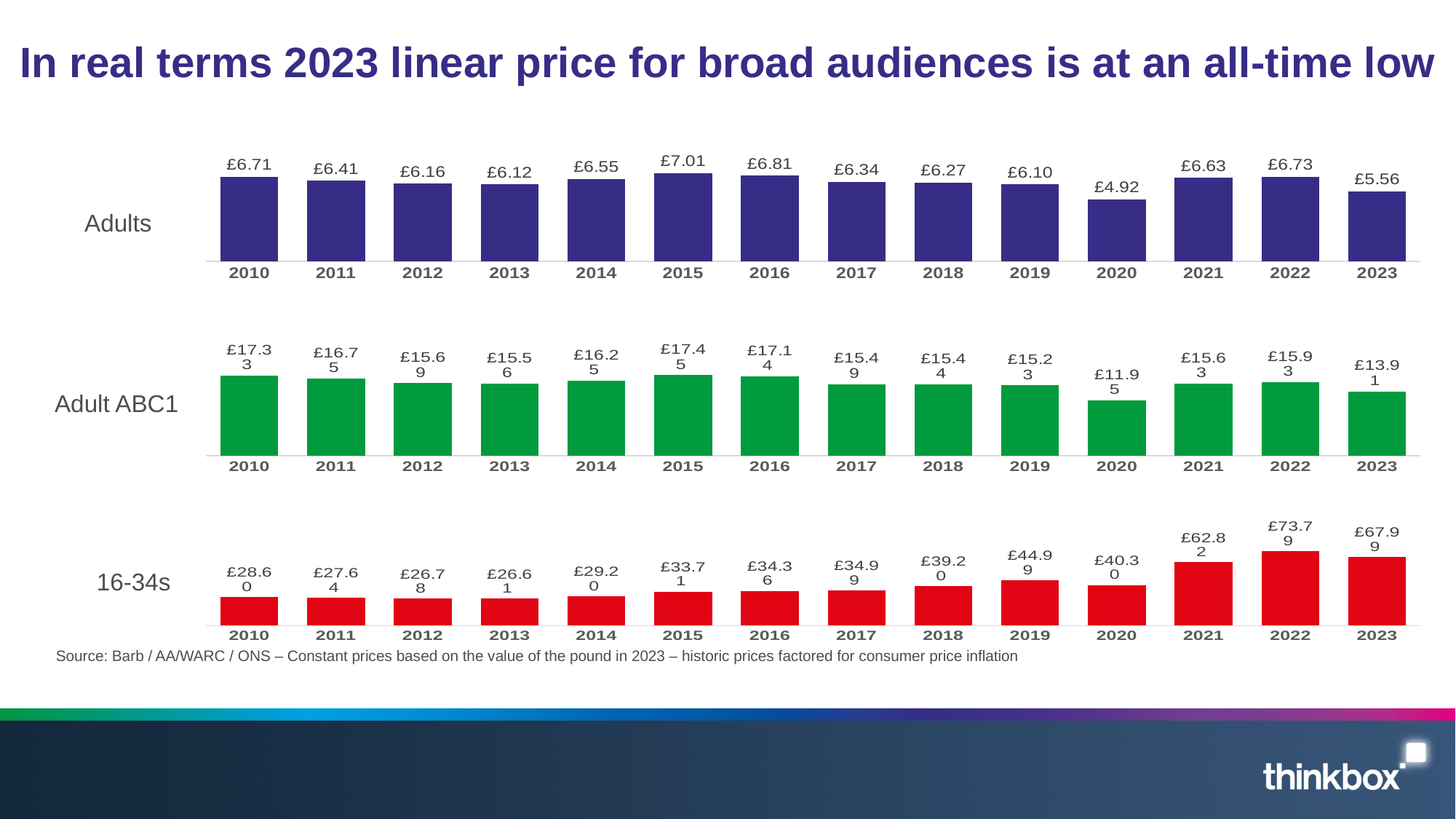
In the Adult ABC1 chart, which year has the lowest value? 2020 In the 16-34s chart, which year has the highest value? 2022 In the Adults chart, what is the difference between the 2022 and 2023 values? £1.17 What kind of chart is the Adults chart? Bar chart In the Adults chart, what is the value for 2023? £5.56 In the 16-34s chart, which is larger, the value for 2010 or the value for 2023? 2023 In the Adults chart, how many years are plotted? 14 What colour are the bars in the 16-34s chart? Red In the Adults chart, which year has the lowest value? 2020 In the Adult ABC1 chart, what is the value for 2020? £11.95 In the Adults chart, which year has the highest value? 2015 In the 16-34s chart, what is the value for 2021? £62.82